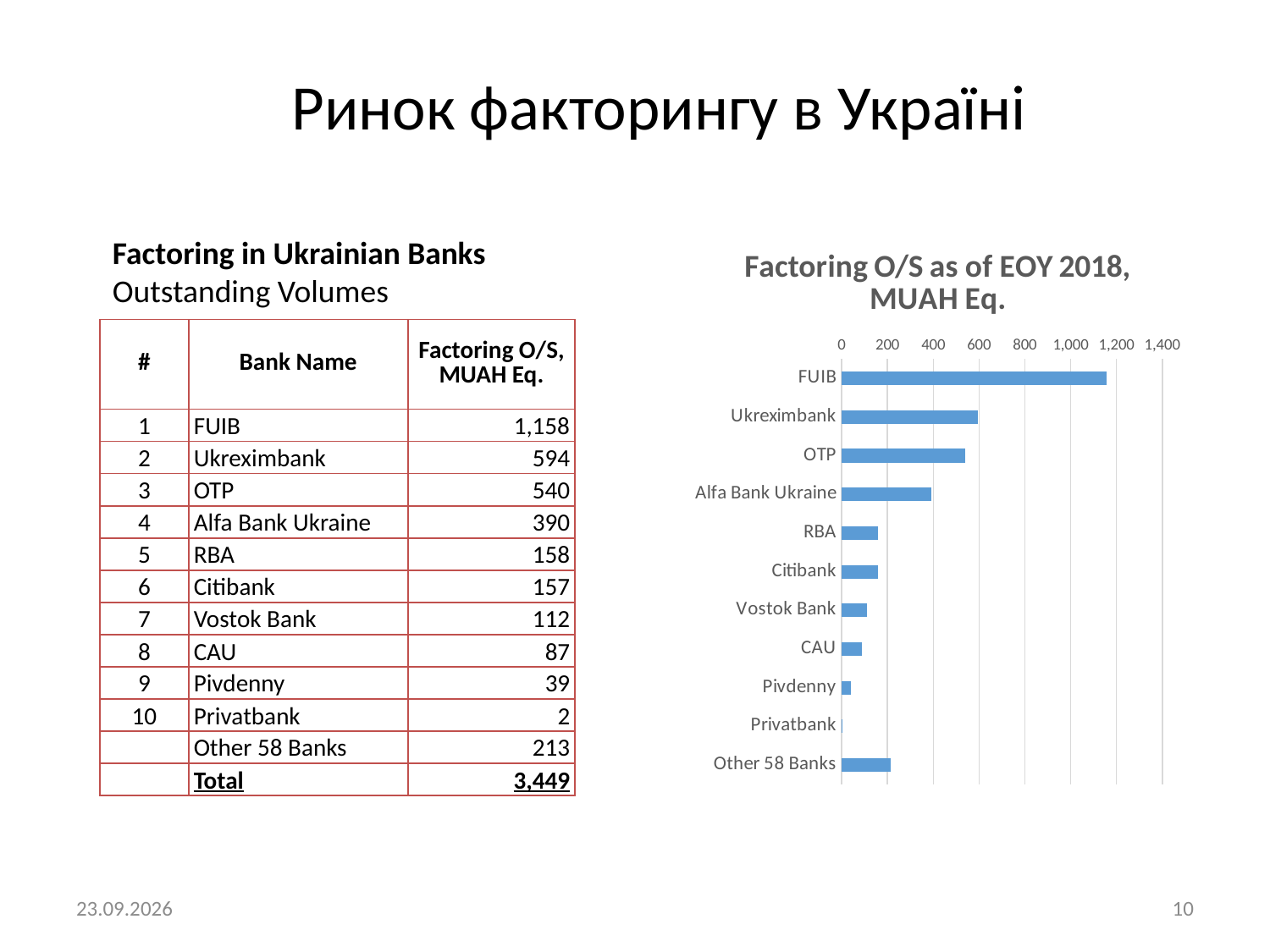
Which bank has the highest factoring O/S in the chart? FUIB Which bank has the lowest factoring O/S in the chart? Privatbank What kind of chart is shown on the slide? bar chart What is the difference between the values for FUIB and Ukreximbank? 564 Is the value for OTP greater or less than 400? greater Is the value for FUIB greater or less than 1,000? greater What is the title of the chart? Factoring O/S as of EOY 2018, MUAH Eq. Is the value for Alfa Bank Ukraine greater or less than 400? less What is the factoring O/S value for FUIB, in MUAH Eq.? 1,158 How many bars (categories) does the chart show? 11 Which is larger, the value for Ukreximbank or the value for Alfa Bank Ukraine? Ukreximbank